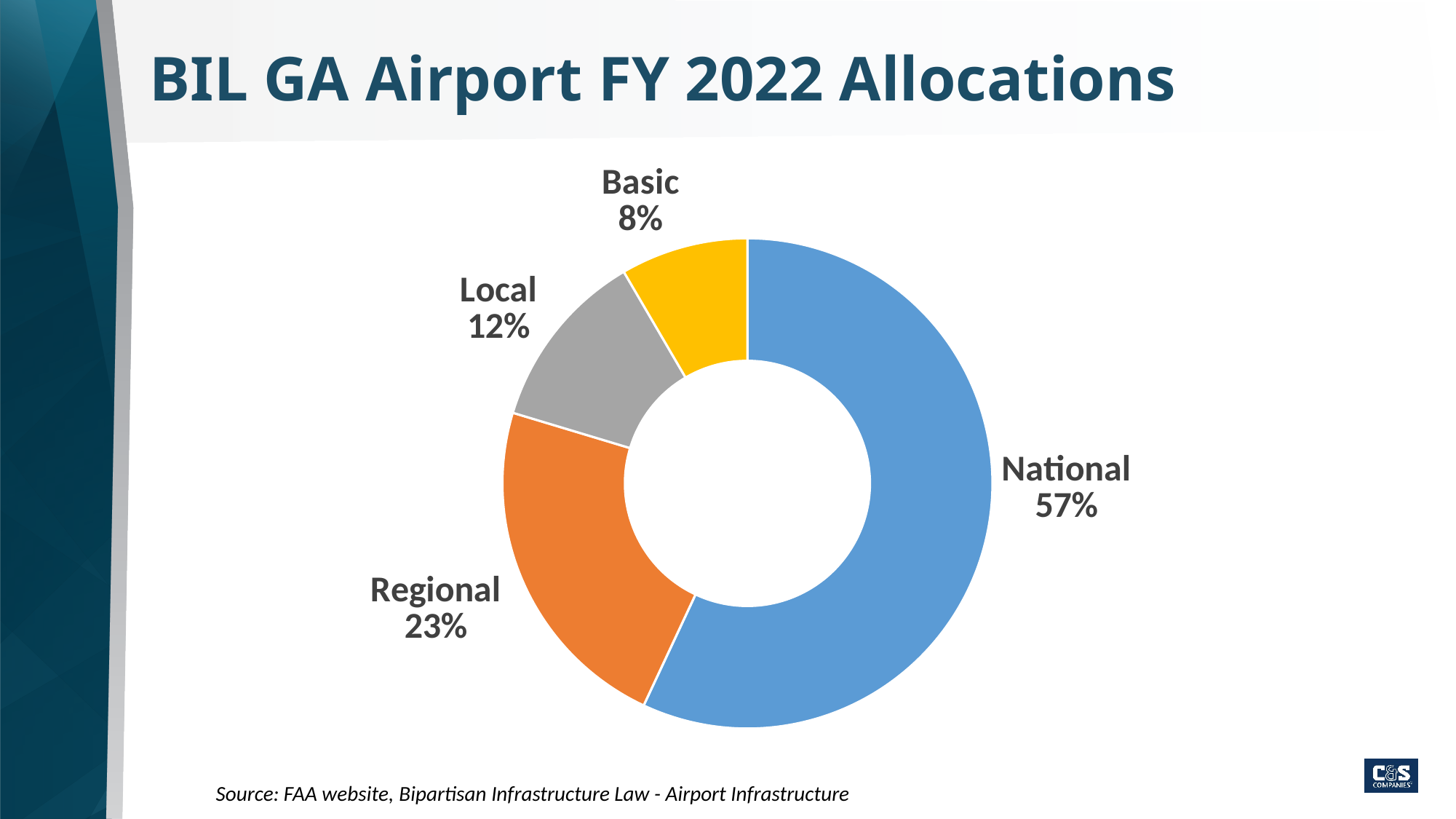
Which category receives the largest share of the allocations? National What colour is the National segment of the chart? Blue What is the difference in percentage points between the Local and Basic shares? 4 How many categories are shown in the chart? 4 Which category has a larger share, Regional or Local? Regional What percentage is shown for the Basic category? 8% What percentage is shown for the Local category? 12% What percentage of the allocations is shown for Regional airports? 23% Which category receives the smallest share of the allocations? Basic What type of chart is shown on the slide? Doughnut (pie) chart What share of the BIL GA Airport FY 2022 allocations goes to National airports? 57% What is the difference in percentage points between the National and Regional shares? 34